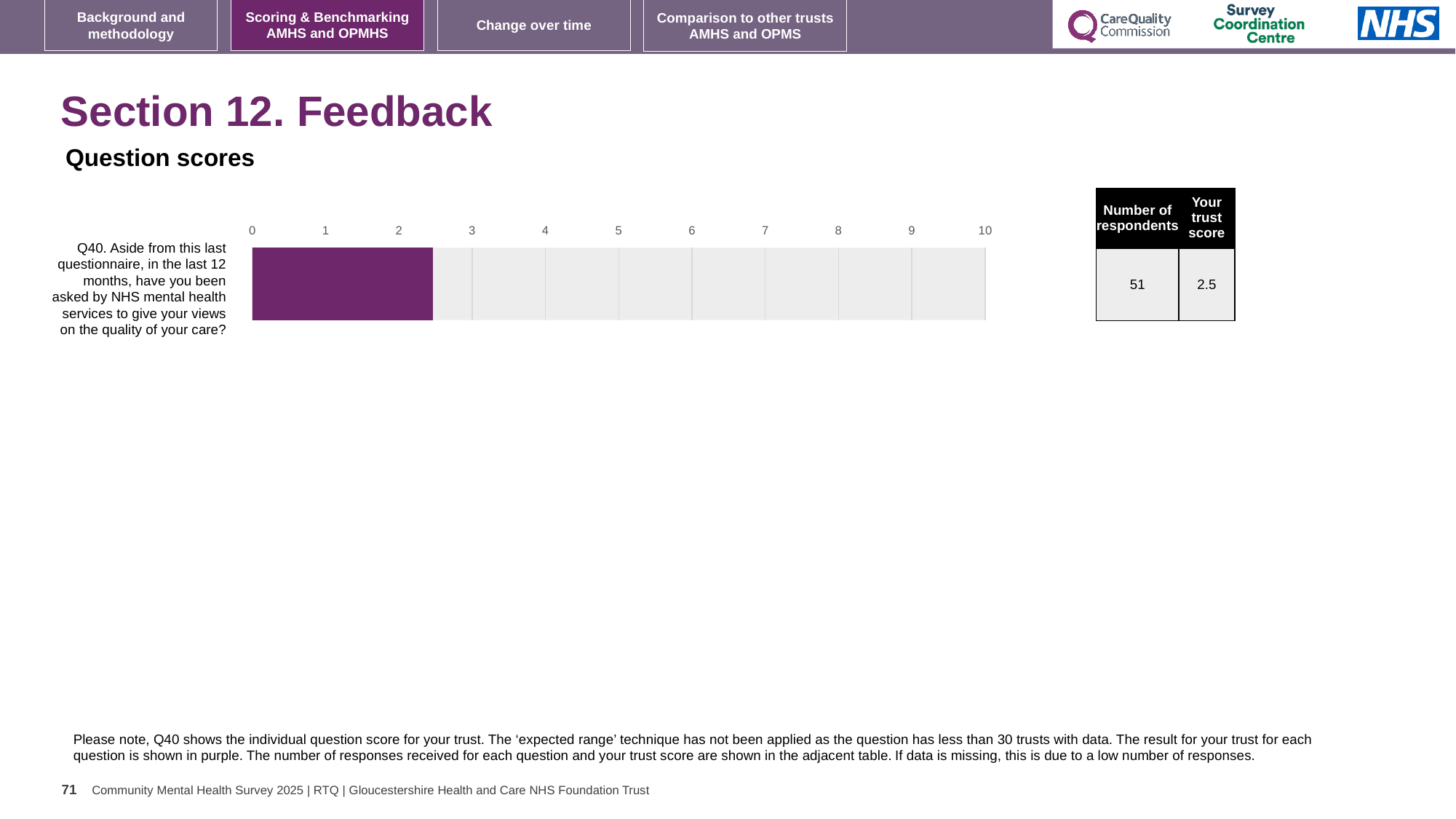
What is the highest value shown on the chart's axis? 10 How many respondents are listed for Q40 in the table? 51 Is the value of the bar for Q40 greater or less than 2? greater Is the value of the bar for Q40 greater or less than 3? less What kind of chart is shown on the slide? bar chart How many questions (bars) are plotted in the chart? 1 What colour is the bar for Q40? purple What is the trust score for Q40 shown in the adjacent table? 2.5 Is the value of the bar for Q40 greater or less than 5? less